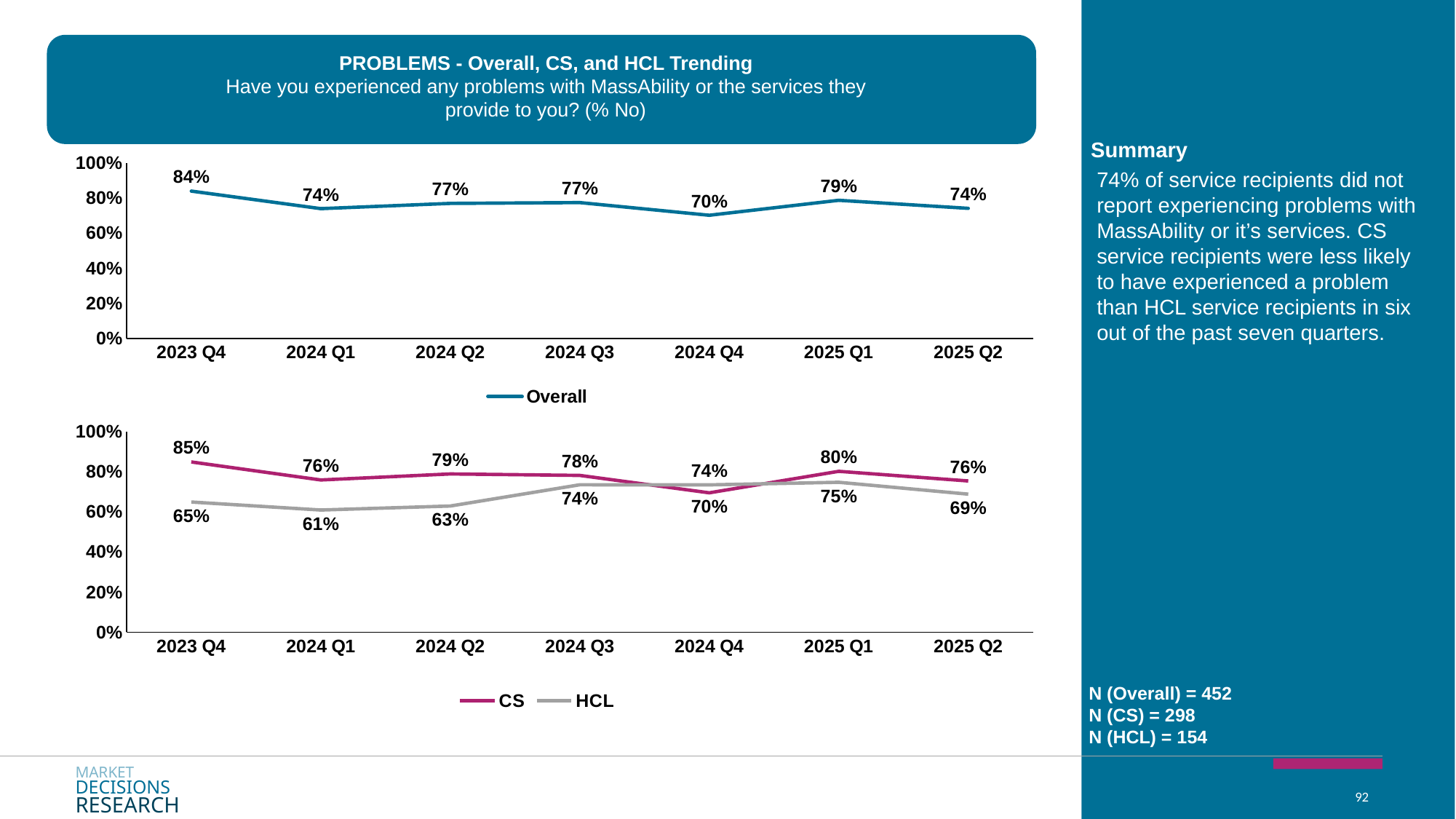
In the bottom chart (CS and HCL), what is the HCL value for 2024 Q1? 61% In the top chart (Overall), what is the difference between the 2023 Q4 value and the 2025 Q2 value? 10% In the top chart (Overall), how many quarters are plotted on the x axis? 7 In the bottom chart (CS and HCL), which series has the larger value in 2024 Q4, CS or HCL? HCL In the bottom chart (CS and HCL), what is the difference between the CS and HCL values in 2023 Q4? 20% In the bottom chart (CS and HCL), which quarter has the lowest HCL value? 2024 Q1 In the bottom chart (CS and HCL), which quarter has the highest CS value? 2023 Q4 In the top chart (Overall), which quarter has the lowest value? 2024 Q4 What type of chart is the top chart (Overall)? Line chart In the bottom chart (CS and HCL), what is the CS value for 2025 Q1? 80% In the top chart (Overall), what is the value for 2023 Q4? 84% In the bottom chart (CS and HCL), how many series does the legend list? 2